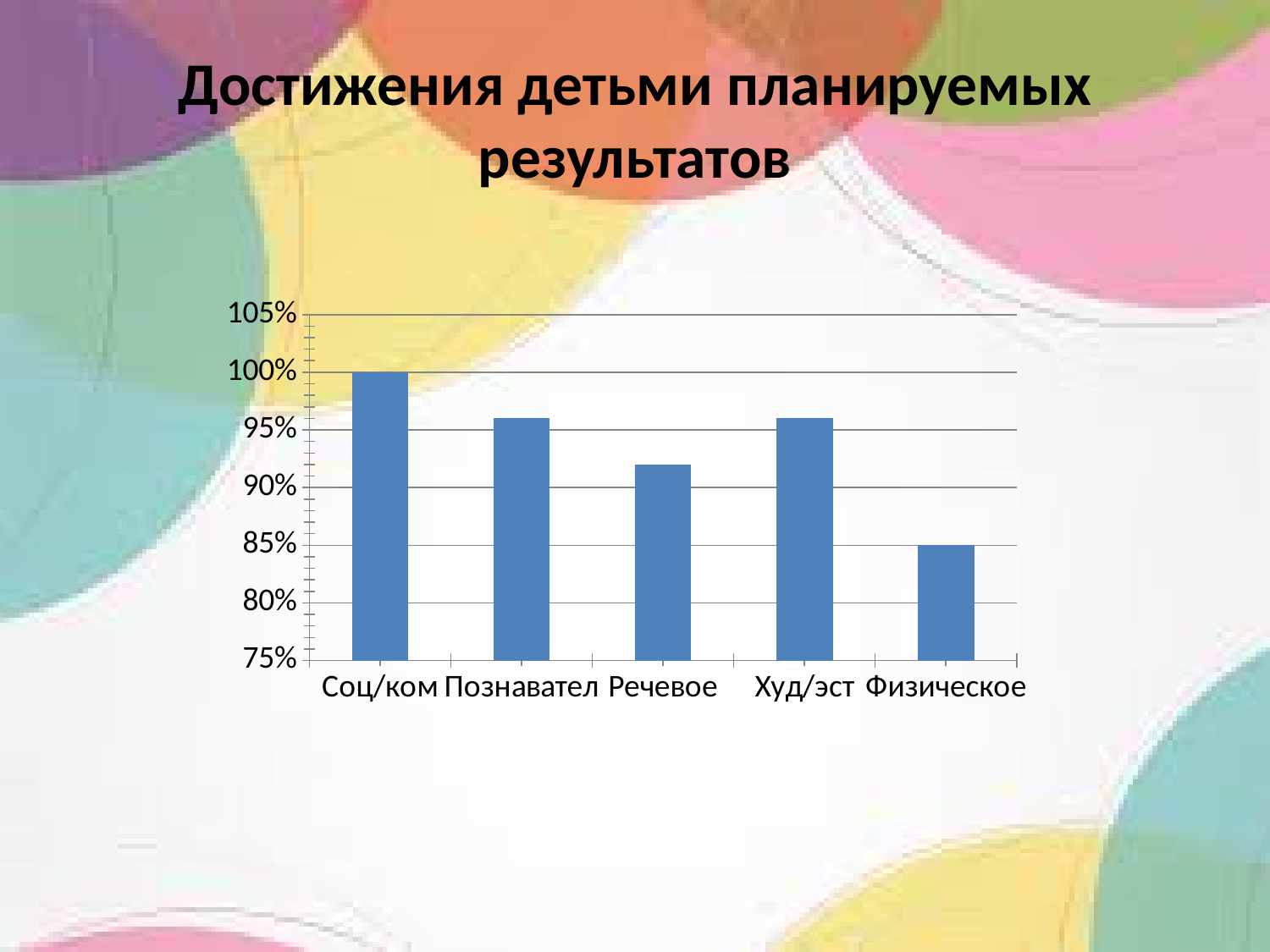
Which category has the highest value? Соц/ком Which is larger, the value for Речевое or the value for Физическое? Речевое What type of chart is shown on the slide? Bar chart Which category has the lowest value? Физическое What is the title of the slide containing the chart? Достижения детьми планируемых результатов Is the value for Худ/эст greater or less than 95%? greater Is the value for Познавател greater or less than 95%? greater What is the value for Соц/ком? 100% What is the value for Физическое? 85% How many categories are shown on the x axis of the chart? 5 Is the value for Речевое greater or less than 95%? less What is the difference between the values for Соц/ком and Физическое? 15%